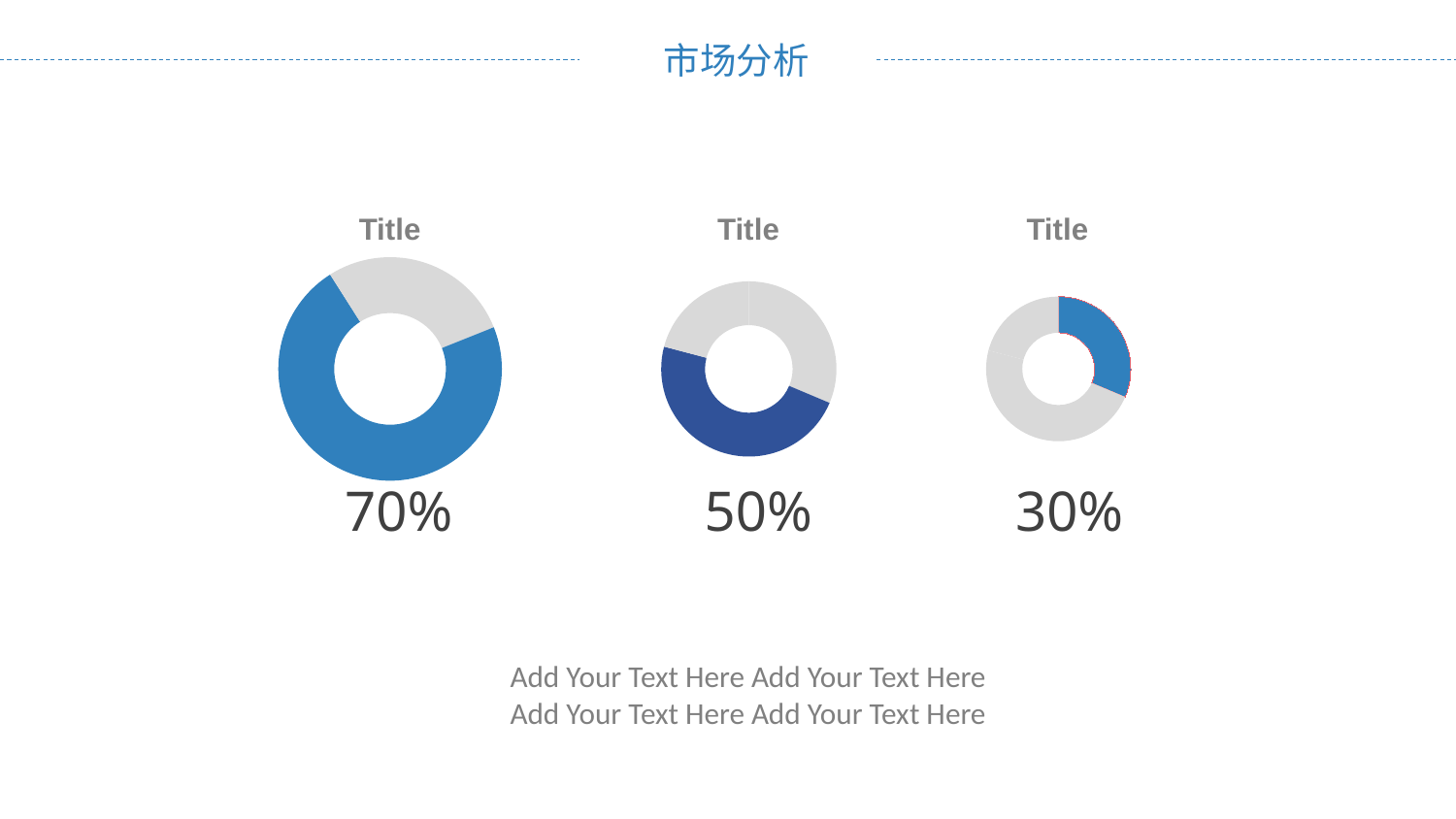
How many donut charts are on the slide? 3 What is the title of the slide? 市场分析 What colour is the filled segment of the middle donut chart? dark blue What percentage is shown below the right donut chart? 30% What percentage is shown below the middle donut chart? 50% What is the difference between the percentage shown under the left donut chart and the percentage under the right donut chart? 40% Which of the three donut charts shows the highest percentage: left, middle or right? left What is the difference between the percentage shown under the left donut chart and the percentage under the middle donut chart? 20% What kind of chart is used for each of the three figures on the slide? donut chart Which of the three donut charts shows the lowest percentage: left, middle or right? right Which shows a larger percentage, the middle donut chart or the right donut chart? middle What percentage is shown below the left donut chart? 70%